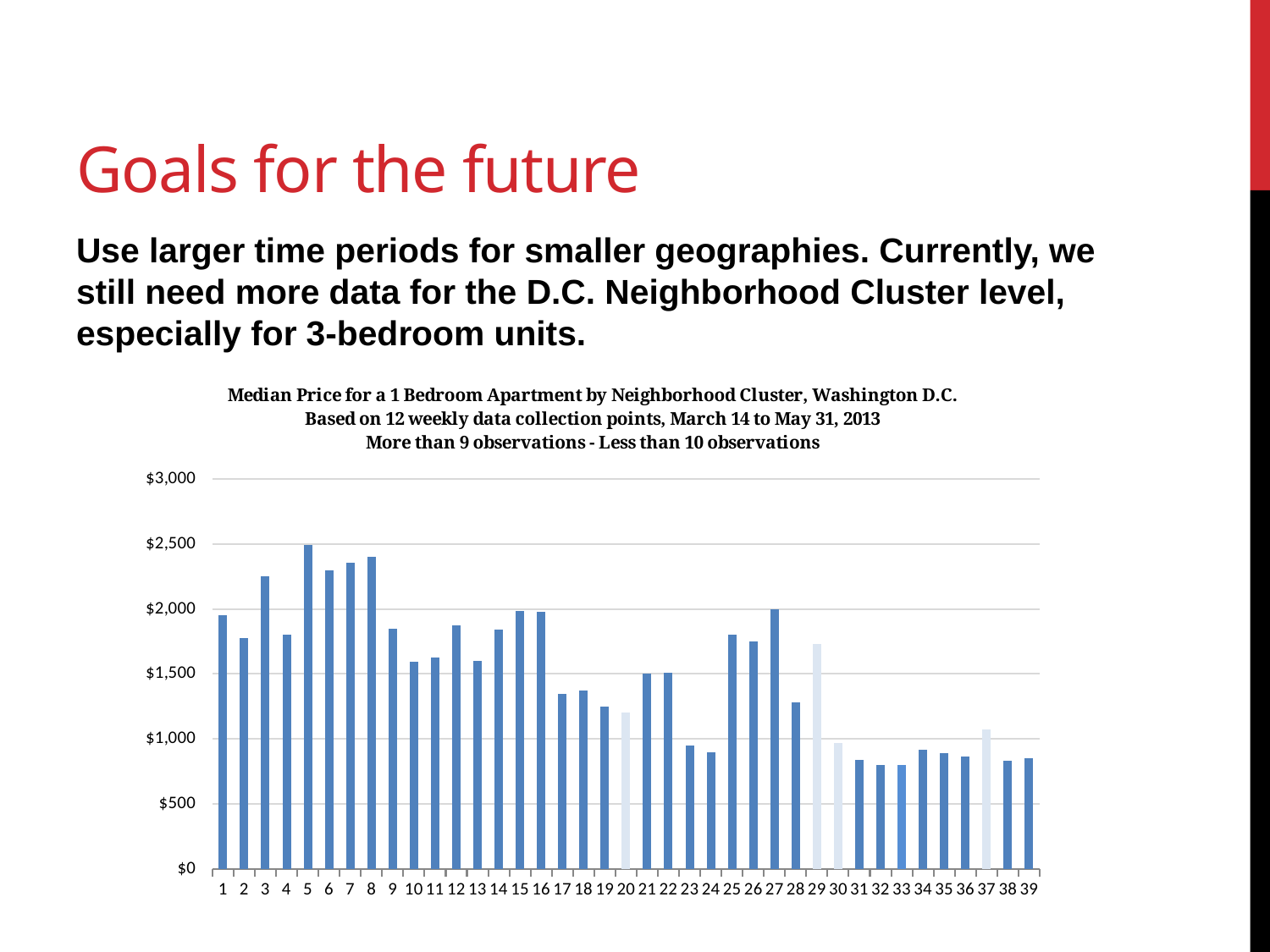
Do the median prices generally rise or fall moving from cluster 1 to cluster 39? fall Is the value for cluster 20 greater or less than $1,000? greater Is the value for cluster 3 greater or less than $2,000? greater What is the highest value shown on the y axis of the chart? $3,000 Which neighborhood cluster has the highest median price for a 1 bedroom apartment? 5 Which has a higher median price, cluster 25 or cluster 28? cluster 25 What kind of chart is shown on the slide? bar chart How many neighborhood clusters are plotted along the x axis? 39 Which has a higher median price, cluster 3 or cluster 4? cluster 3 Is the value for cluster 1 greater or less than $1,500? greater